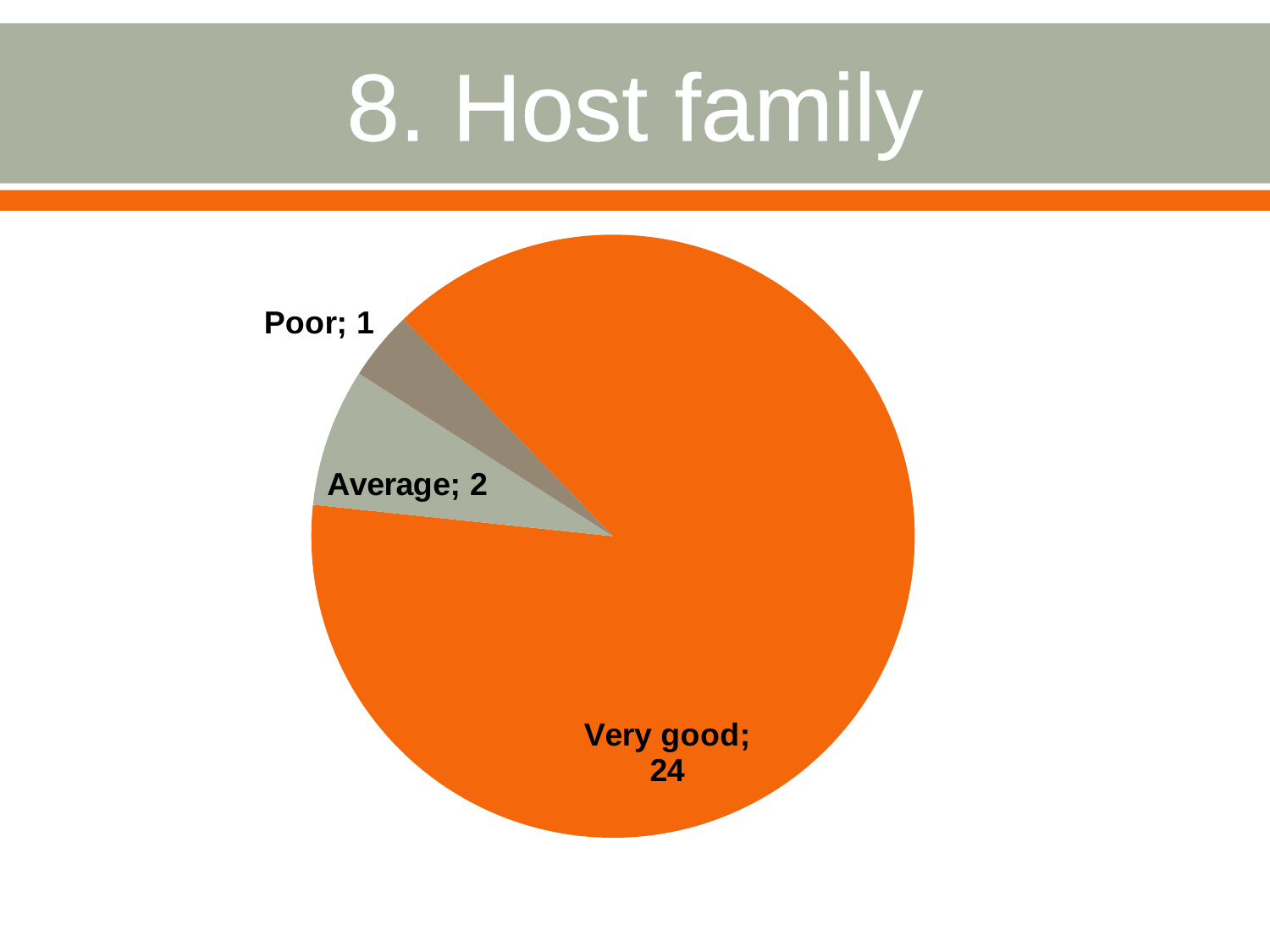
What kind of chart is shown on the slide? pie chart Which category has the lowest value? Poor What is the difference between the values for Average and Poor? 1 What is the value for Poor? 1 Which category has the highest value? Very good What is the value for Average? 2 How many slices does the pie chart have? 3 What is the value for Very good? 24 Which is larger, the value for Average or the value for Poor? Average What is the difference between the values for Very good and Average? 22 What is the total of all slices in the pie chart? 27 What is the title of the slide containing the chart? 8. Host family